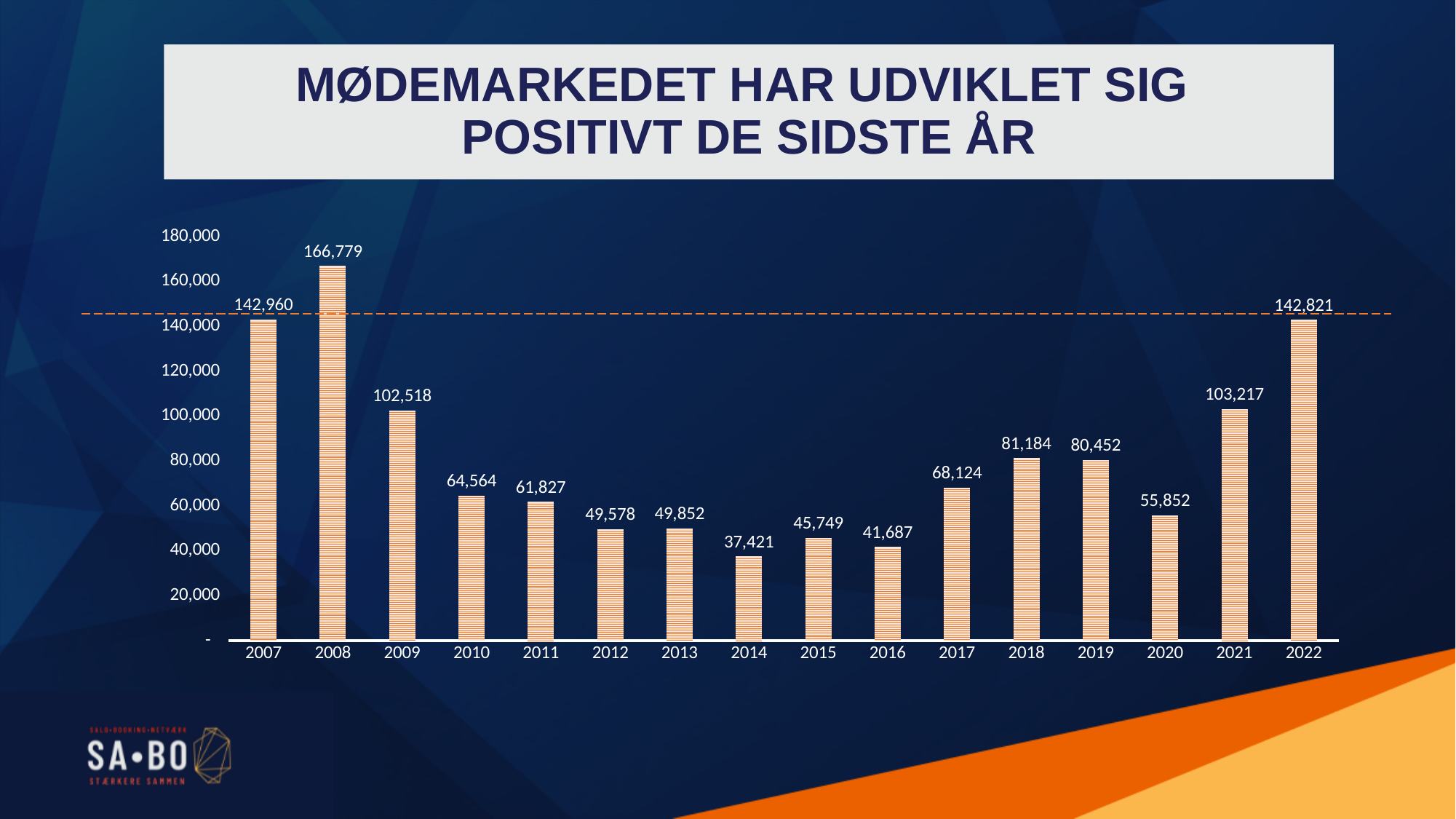
What is the value for 2017? 68,124 Which is larger, the value for 2020 or the value for 2016? 2020 What kind of chart is shown on the slide? bar chart What is the value for 2022? 142,821 Which year has the highest value? 2008 What is the difference between the values for 2022 and 2021? 39,604 What is the value for 2008? 166,779 How many years are shown on the x axis? 16 What is the difference between the values for 2008 and 2007? 23,819 Is the value for 2020 greater or less than 60,000? less What is the value for 2014? 37,421 Which year has the lowest value? 2014